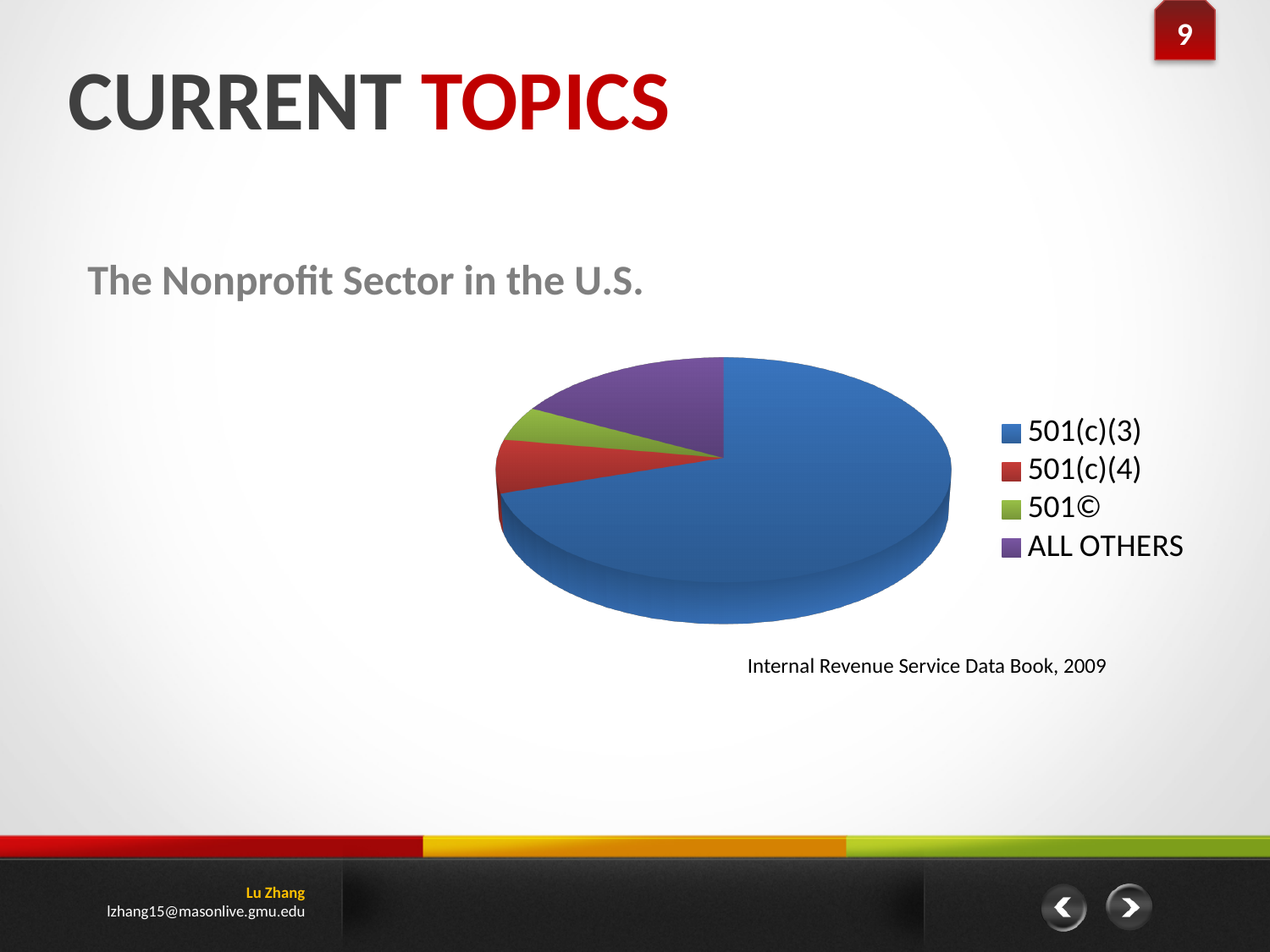
Which slice is larger in the pie chart, 501(c)(3) or 501(c)(4)? 501(c)(3) Does the 501(c)(3) slice make up more or less than half of the pie chart? more Which slice is larger in the pie chart, ALL OTHERS or 501(c)(4)? ALL OTHERS How many slices does the pie chart have? 4 Which slice is larger in the pie chart, 501(c)(3) or ALL OTHERS? 501(c)(3) What kind of chart is shown on the slide? pie chart How many entries does the legend of the pie chart list? 4 Which category has the largest slice of the pie chart? 501(c)(3) What colour is the 501(c)(3) slice in the pie chart? blue Which category has the smallest slice of the pie chart? 501© What data source is cited below the pie chart? Internal Revenue Service Data Book, 2009